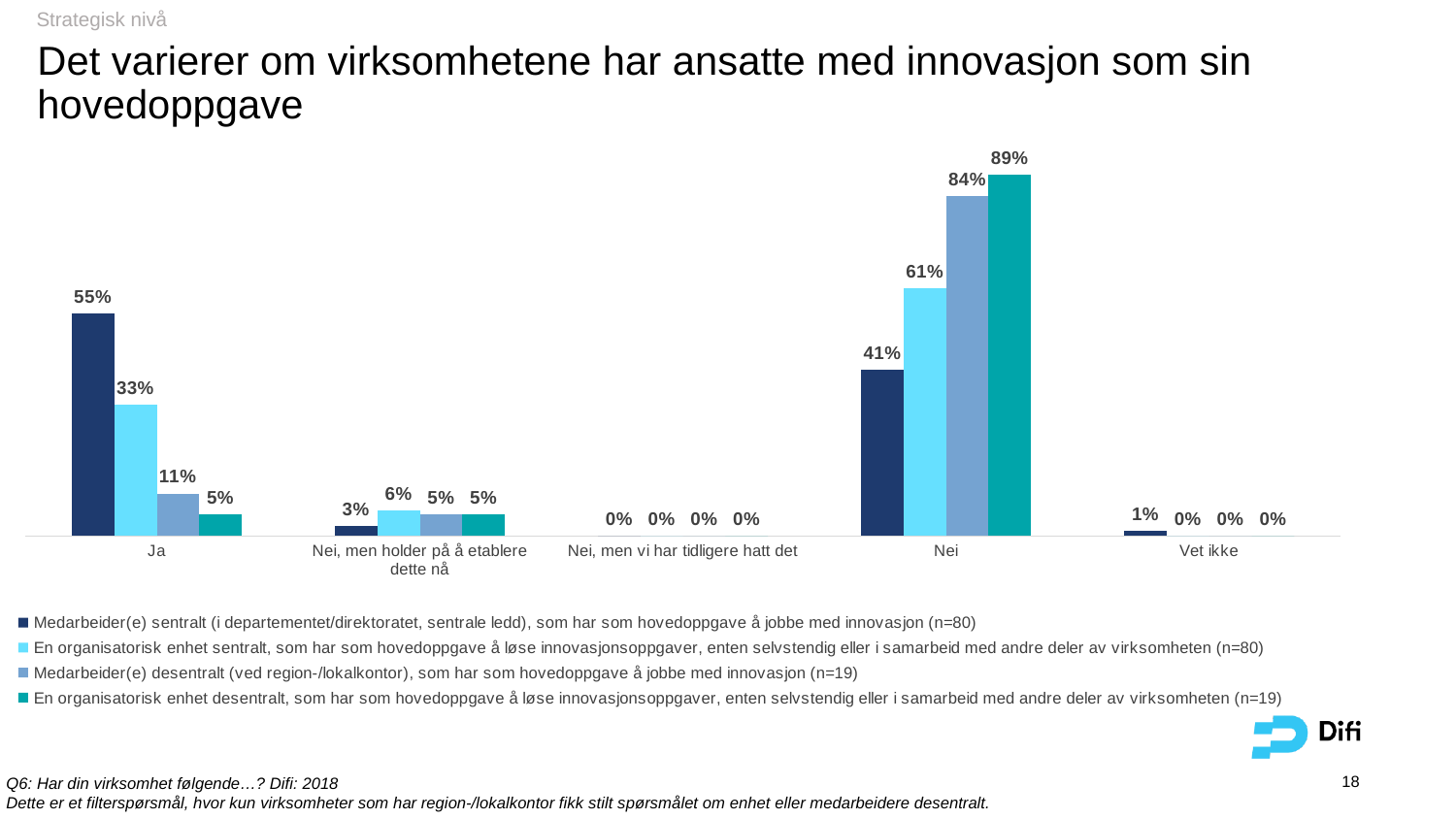
What is the value for 'Ja' for the series 'Medarbeider(e) sentralt (i departementet/direktoratet, sentrale ledd), som har som hovedoppgave å jobbe med innovasjon (n=80)'? 55% Which series has the lowest value for the category 'Ja'? En organisatorisk enhet desentralt, som har som hovedoppgave å løse innovasjonsoppgaver, enten selvstendig eller i samarbeid med andre deler av virksomheten (n=19) What value do all four series show for the category 'Nei, men vi har tidligere hatt det'? 0% How many categories are shown on the x axis of the chart? 5 What is the value for 'Nei' for the series 'En organisatorisk enhet desentralt, som har som hovedoppgave å løse innovasjonsoppgaver, enten selvstendig eller i samarbeid med andre deler av virksomheten (n=19)'? 89% What is the difference between the 'Nei' values for the series 'En organisatorisk enhet sentralt ... (n=80)' and 'Medarbeider(e) sentralt ... (n=80)'? 20% For the category 'Ja', which is larger: the value for 'Medarbeider(e) sentralt ... (n=80)' or the value for 'En organisatorisk enhet sentralt ... (n=80)'? Medarbeider(e) sentralt ... (n=80) How many series does the chart's legend list? 4 Which category has the highest value for the series 'Medarbeider(e) desentralt (ved region-/lokalkontor), som har som hovedoppgave å jobbe med innovasjon (n=19)'? Nei What is the value for 'Vet ikke' for the series 'Medarbeider(e) sentralt (i departementet/direktoratet, sentrale ledd), som har som hovedoppgave å jobbe med innovasjon (n=80)'? 1% What is the value for 'Nei, men holder på å etablere dette nå' for the series 'En organisatorisk enhet sentralt, som har som hovedoppgave å løse innovasjonsoppgaver, enten selvstendig eller i samarbeid med andre deler av virksomheten (n=80)'? 6% What kind of chart is shown on the slide? Bar chart